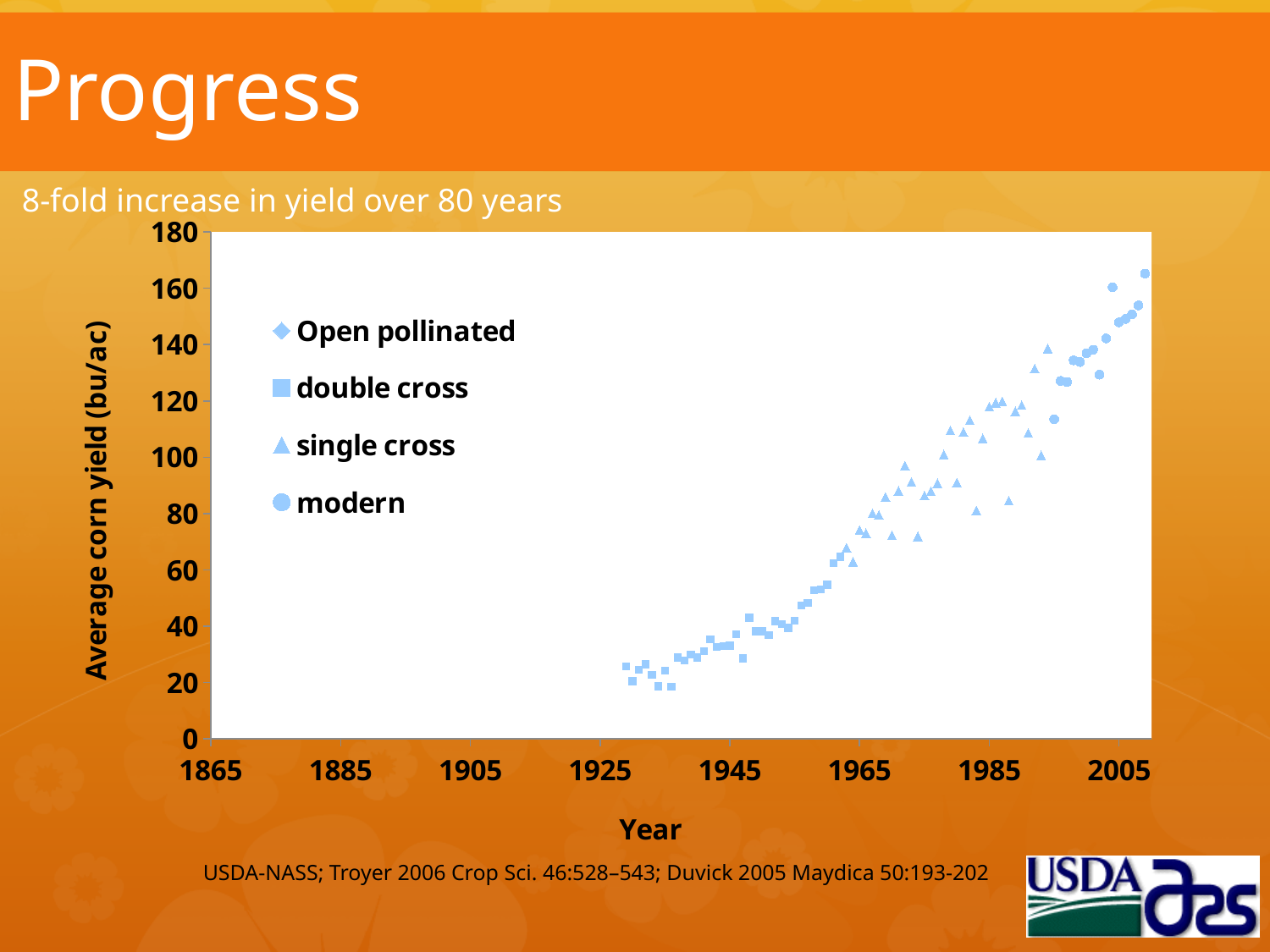
Which series has larger yield values, 'modern' or 'double cross'? modern Are the highest 'modern' points near 2005 greater or less than 140 bu/ac? greater Which series contains the lowest plotted yield values? double cross Which series contains the highest plotted yield values? modern What are the four series listed in the chart legend? Open pollinated, double cross, single cross, modern What kind of chart is shown on the slide? scatter chart Are the earliest 'double cross' points around 1930 greater or less than 40 bu/ac? less What is the label of the vertical axis of the chart? Average corn yield (bu/ac) Do the plotted yield values rise or fall as the year increases along the x axis? rise What is the maximum value shown on the vertical axis of the chart? 180 How many series does the chart legend list? 4 Are the 'single cross' points around 1965 greater or less than 40 bu/ac? greater